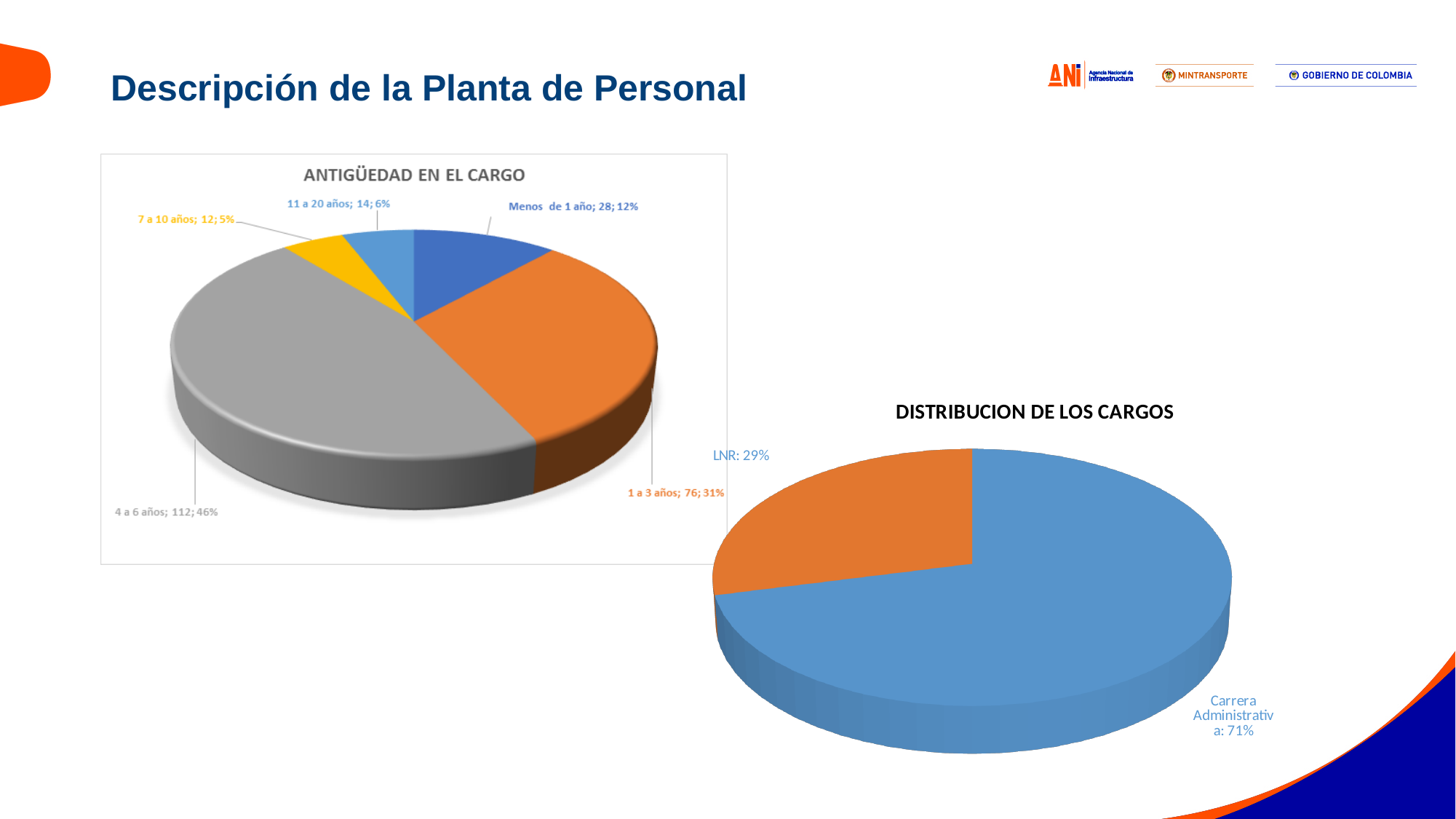
What kind of chart is 'ANTIGÜEDAD EN EL CARGO'? Pie chart In the 'ANTIGÜEDAD EN EL CARGO' chart, how many people have been in their position for 4 a 6 años? 112 In the 'ANTIGÜEDAD EN EL CARGO' chart, what percentage share does the '1 a 3 años' slice have? 31% In the 'ANTIGÜEDAD EN EL CARGO' chart, which category has the smallest slice? 7 a 10 años In the 'DISTRIBUCION DE LOS CARGOS' chart, which category has the larger slice? Carrera Administrativa How many categories are shown in the 'ANTIGÜEDAD EN EL CARGO' chart? 5 In the 'DISTRIBUCION DE LOS CARGOS' chart, what share does 'Carrera Administrativa' have? 71% In the 'DISTRIBUCION DE LOS CARGOS' chart, what share does 'LNR' have? 29% In the 'ANTIGÜEDAD EN EL CARGO' chart, what is the difference in count between '1 a 3 años' and 'Menos de 1 año'? 48 In the 'ANTIGÜEDAD EN EL CARGO' chart, what colour is the '4 a 6 años' slice? Grey In the 'ANTIGÜEDAD EN EL CARGO' chart, which category has the largest slice? 4 a 6 años In the 'ANTIGÜEDAD EN EL CARGO' chart, which is larger: '11 a 20 años' or '7 a 10 años'? 11 a 20 años